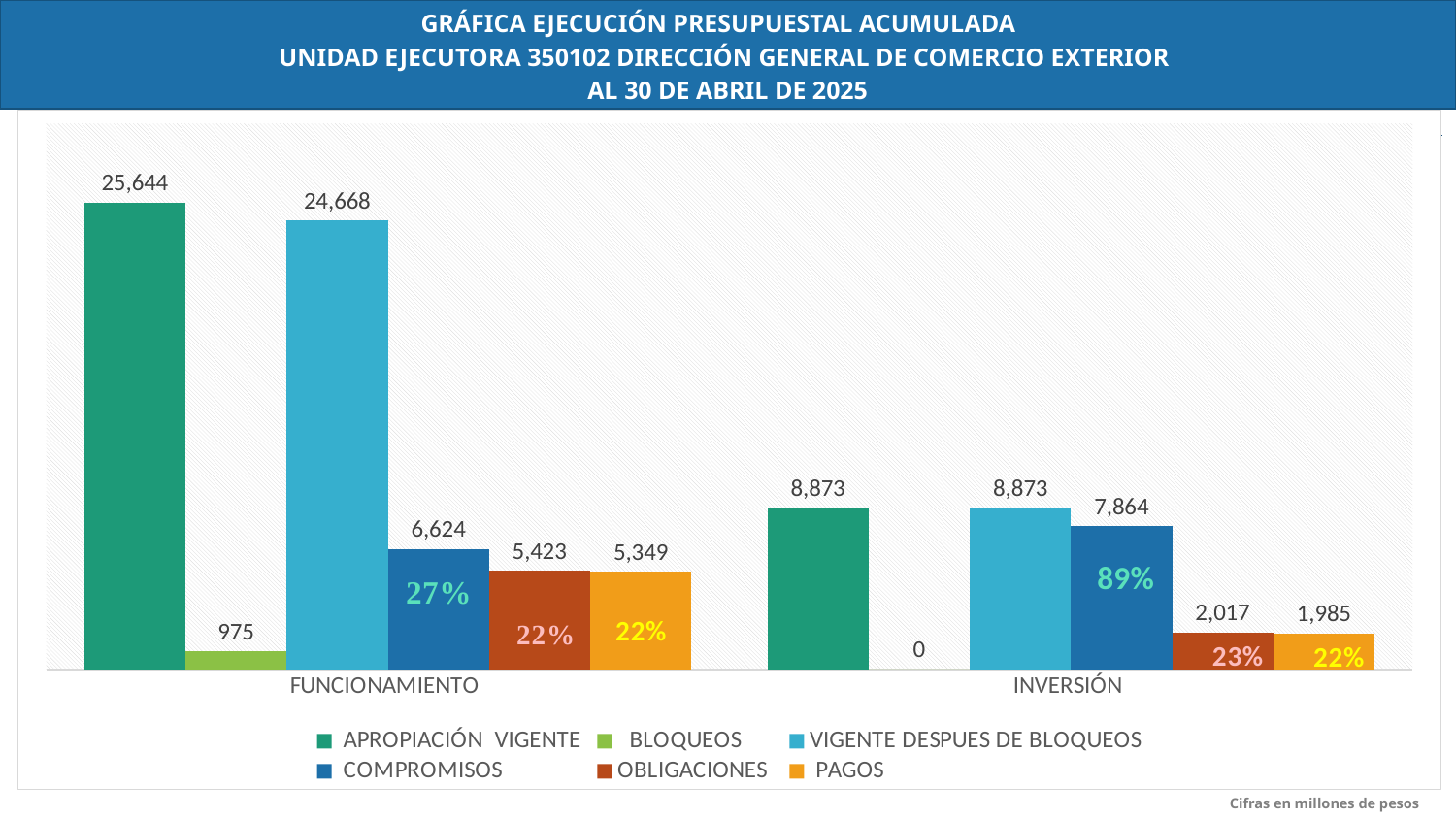
What is the value of BLOQUEOS for INVERSIÓN? 0 What is the difference between OBLIGACIONES and PAGOS for INVERSIÓN? 32 How many series does the legend list? 6 What is the difference between APROPIACIÓN VIGENTE and VIGENTE DESPUES DE BLOQUEOS for FUNCIONAMIENTO? 976 What is the value of COMPROMISOS for INVERSIÓN? 7,864 Which series has the highest value for FUNCIONAMIENTO? APROPIACIÓN VIGENTE What is the value of APROPIACIÓN VIGENTE for FUNCIONAMIENTO? 25,644 Which series has the lowest value for INVERSIÓN? BLOQUEOS Which is larger, COMPROMISOS for FUNCIONAMIENTO or COMPROMISOS for INVERSIÓN? COMPROMISOS for INVERSIÓN What is the value of PAGOS for INVERSIÓN? 1,985 What is the value of BLOQUEOS for FUNCIONAMIENTO? 975 What kind of chart is shown on the slide? Bar chart